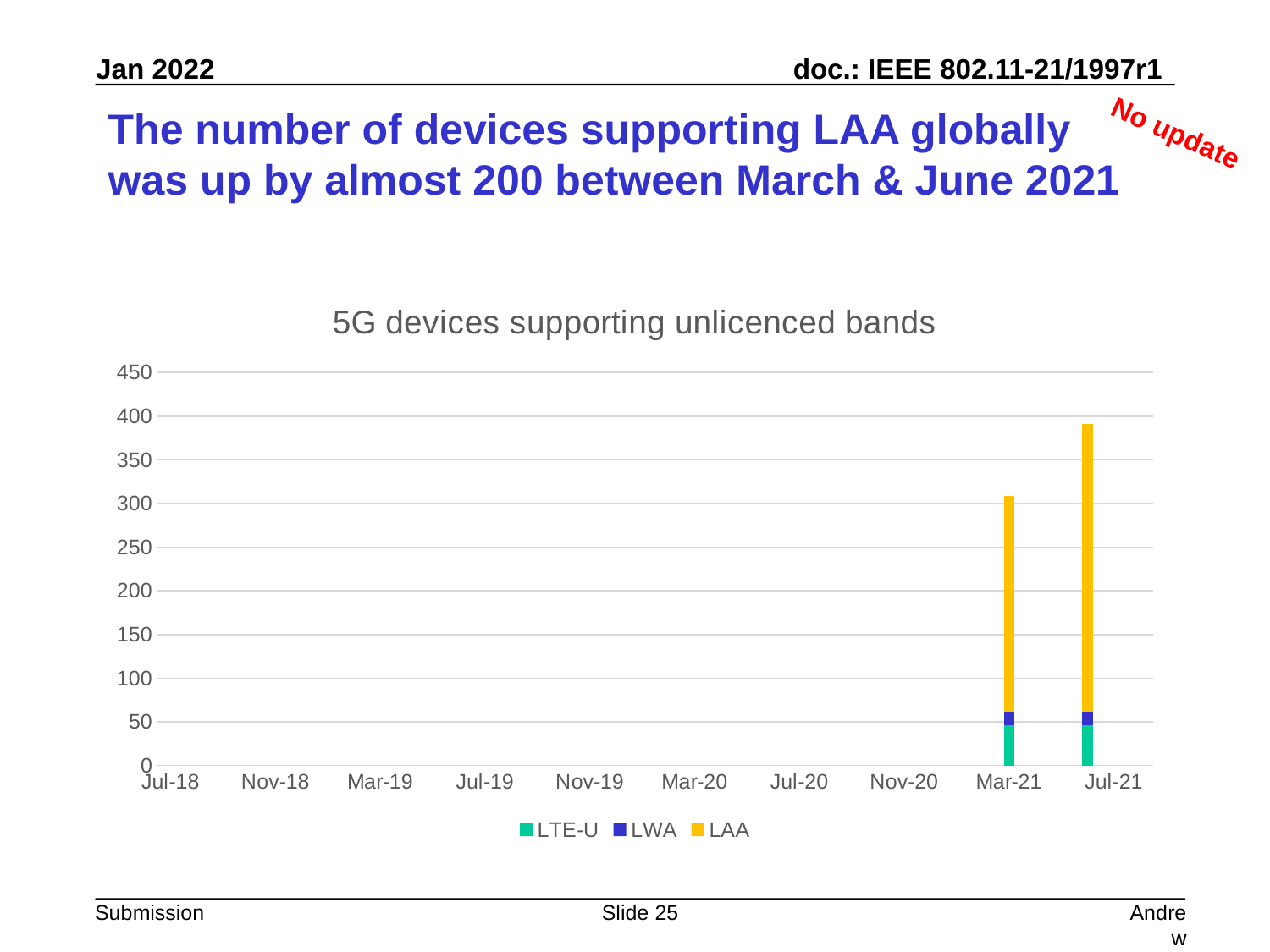
Which bar is taller, the bar at Mar-21 or the rightmost bar? the rightmost bar Is the LTE-U segment of the bar at Mar-21 greater or less than 100? less Do the bar totals rise or fall from the Mar-21 bar to the rightmost bar? rise Is the total of the bar at Mar-21 greater or less than 250? greater What is the title of the chart? 5G devices supporting unlicenced bands Is the total of the rightmost bar greater or less than 350? greater What kind of chart is shown on the slide? stacked bar chart Which series makes up the largest segment of the rightmost bar? LAA Which series are listed in the chart legend? LTE-U, LWA, LAA How many series does the chart legend list? 3 How many bars are plotted on the chart? 2